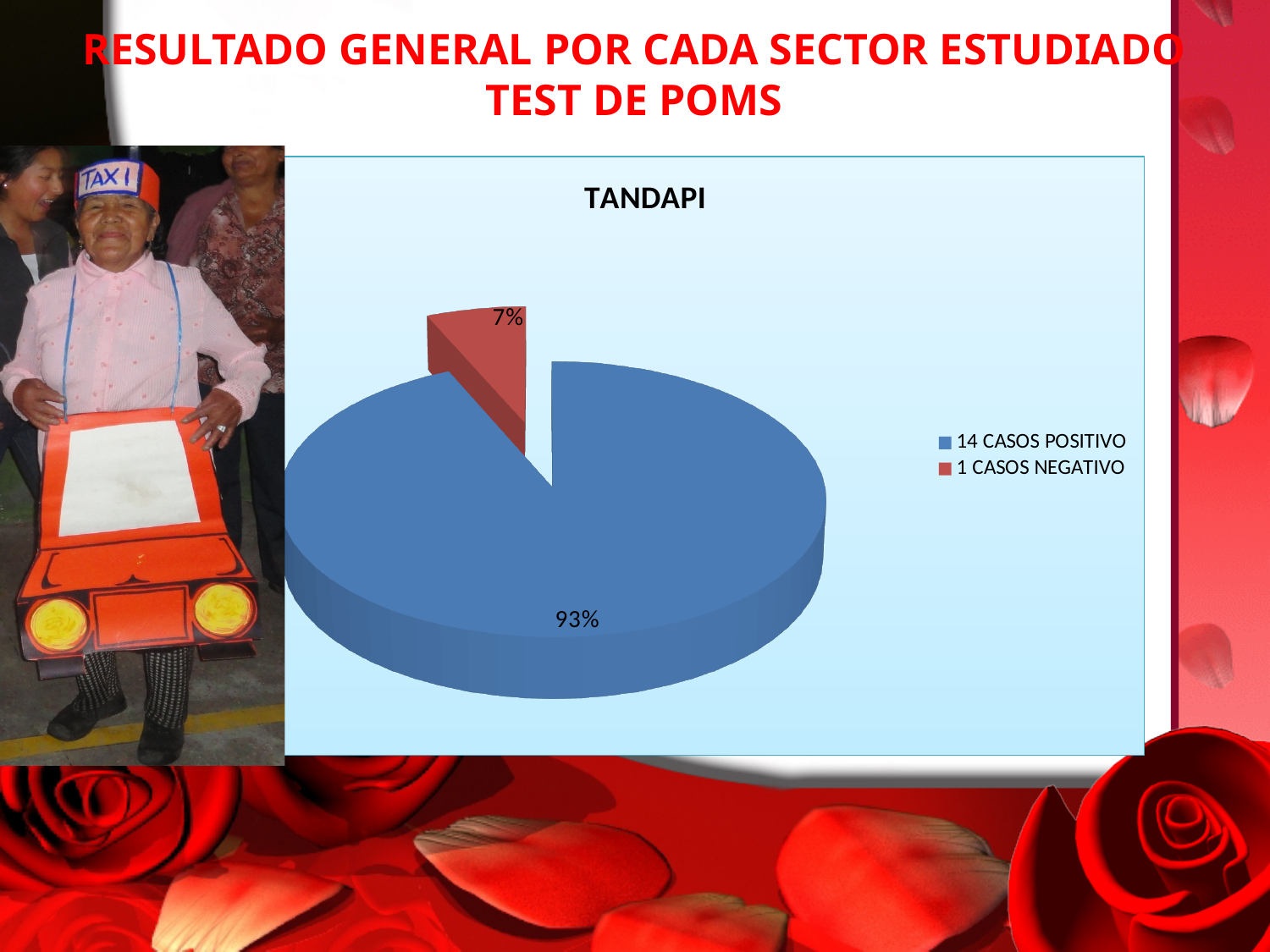
What percentage is shown for the 1 CASOS NEGATIVO slice? 7% Which is larger, the 14 CASOS POSITIVO slice or the 1 CASOS NEGATIVO slice? 14 CASOS POSITIVO What percentage is shown for the 14 CASOS POSITIVO slice? 93% What kind of chart is shown on the slide? pie chart What share of the pie does the 14 CASOS POSITIVO slice represent? 93% What is the title of the chart? TANDAPI Which slice of the pie is the largest? 14 CASOS POSITIVO What colour is the 1 CASOS NEGATIVO slice? red What is the difference in percentage points between the 14 CASOS POSITIVO slice and the 1 CASOS NEGATIVO slice? 86 Which slice of the pie is the smallest? 1 CASOS NEGATIVO How many slices does the pie chart have? 2 How many entries does the legend list? 2